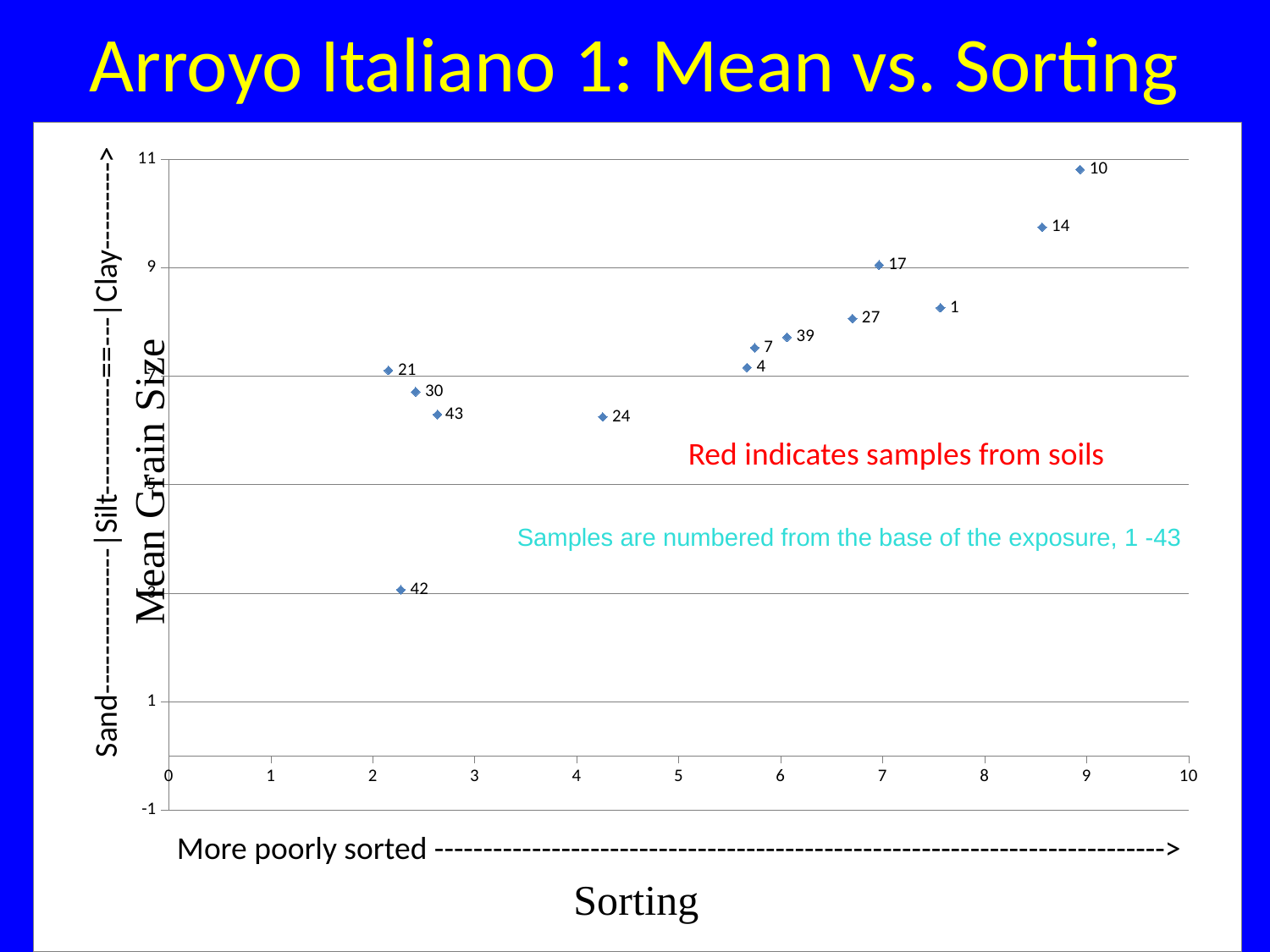
Which sample has the lowest mean grain size? 42 As sorting increases along the x axis, does mean grain size generally rise or fall? rise What is the title of the x axis? Sorting Which sample has the highest sorting value? 10 Is the mean grain size for sample 42 greater or less than 5? less Which has the larger mean grain size, sample 14 or sample 24? sample 14 How many sample points are plotted on the chart? 13 Which sample has the highest mean grain size? 10 Is the sorting value for sample 21 greater or less than 3? less Is the sorting value for sample 17 greater or less than 6? greater What kind of chart is shown on the slide? scatter chart